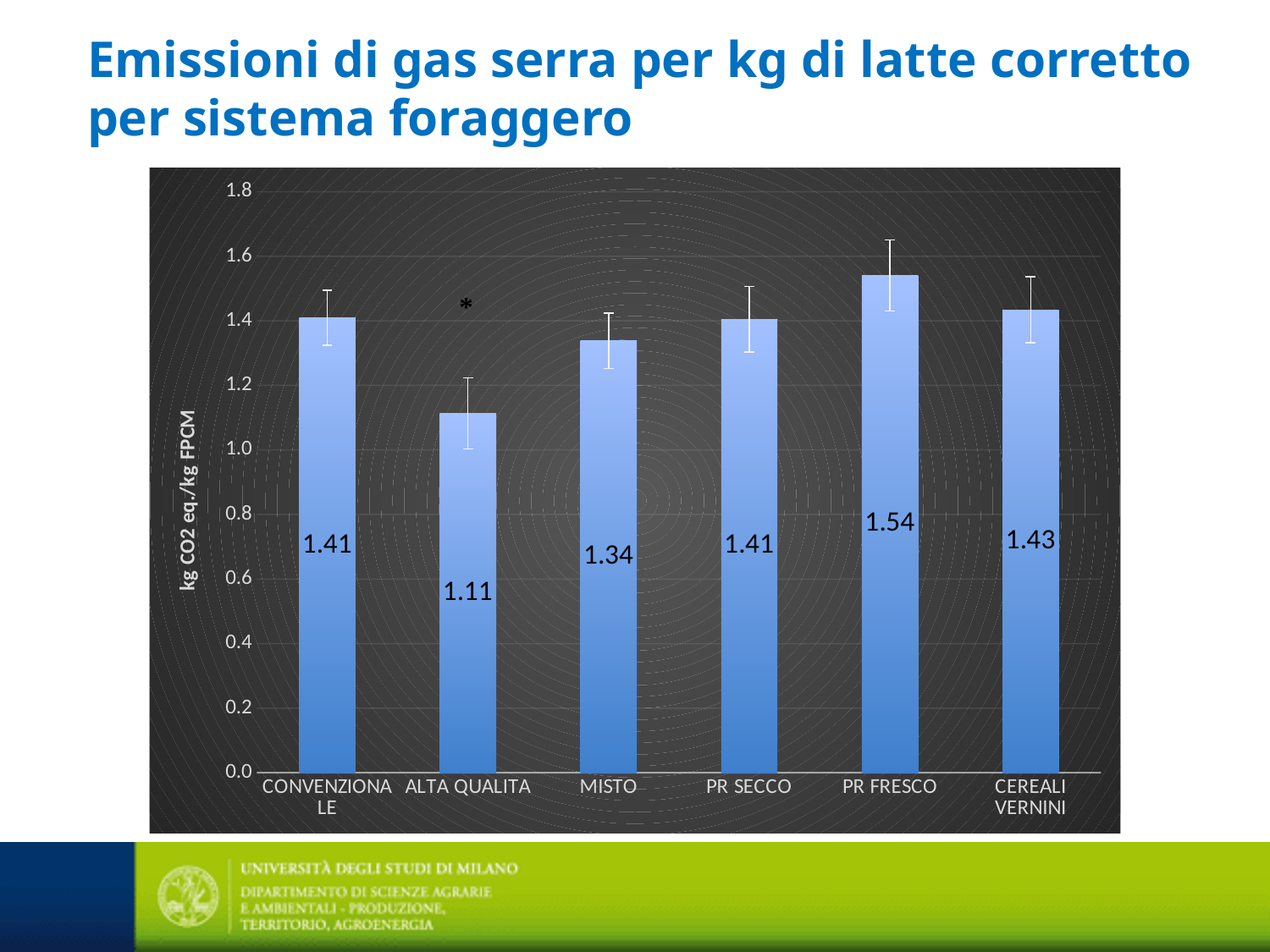
What is the difference between the values for CEREALI VERNINI and MISTO? 0.09 What is the value for ALTA QUALITA? 1.11 How many categories are shown on the x axis? 6 What is the value for CEREALI VERNINI? 1.43 Which category has the highest value? PR FRESCO Which category has the lowest value? ALTA QUALITA What is the difference between the values for PR FRESCO and ALTA QUALITA? 0.43 Which is larger, the value for MISTO or the value for PR SECCO? PR SECCO What kind of chart is shown on the slide? bar chart Is the value for ALTA QUALITA greater or less than 1.2? less What is the value for MISTO? 1.34 What is the value for PR FRESCO? 1.54